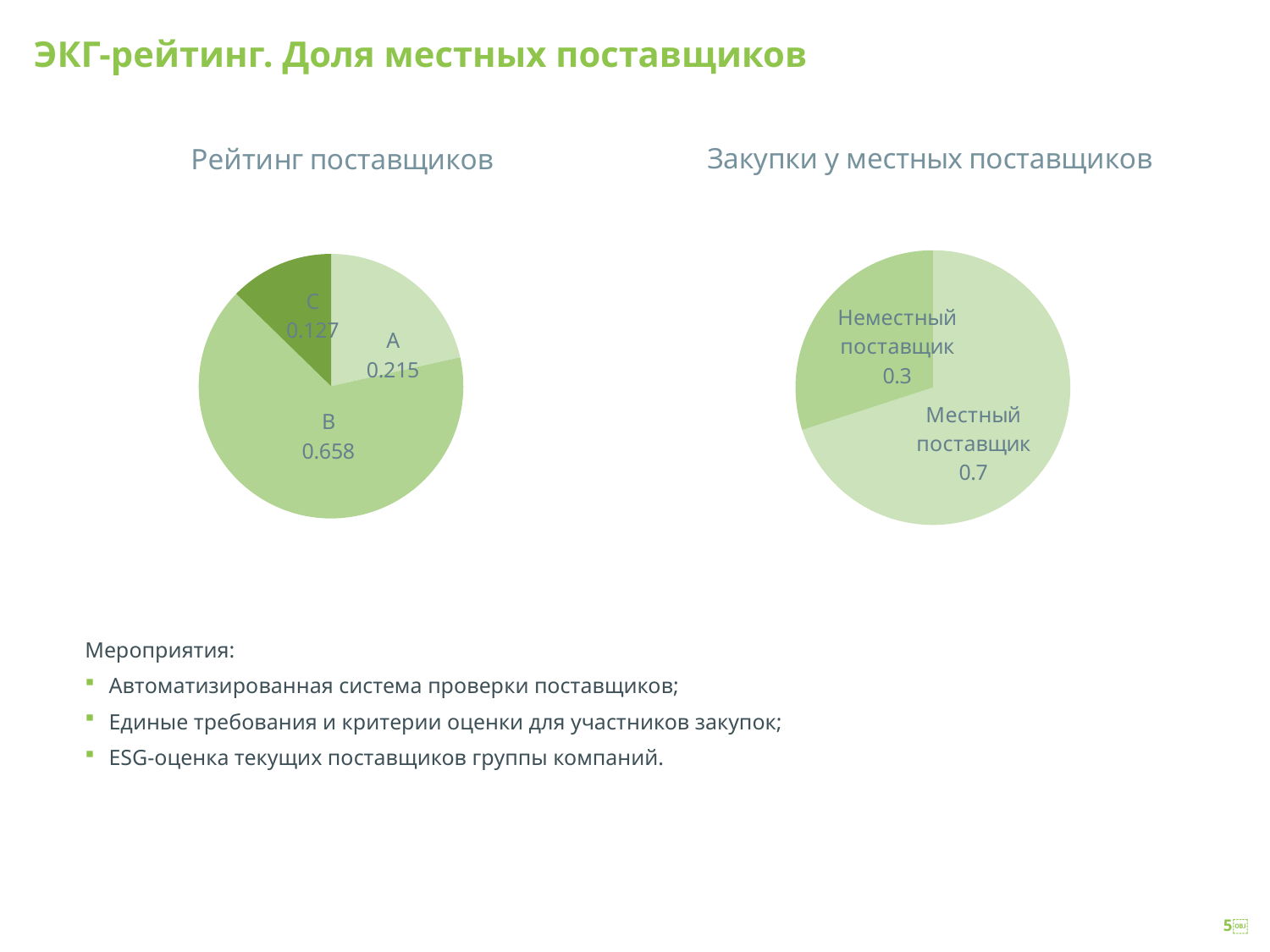
In the 'Рейтинг поставщиков' chart, how many categories are shown? 3 In the 'Рейтинг поставщиков' chart, what is the value for category A? 0.215 In the 'Рейтинг поставщиков' chart, what is the difference between the values for B and A? 0.443 In the 'Рейтинг поставщиков' chart, which category has the smallest slice? C In the 'Рейтинг поставщиков' chart, what is the value for category B? 0.658 What kind of chart is the 'Закупки у местных поставщиков' chart? Pie chart In the 'Закупки у местных поставщиков' chart, which is larger: 'Местный поставщик' or 'Неместный поставщик'? Местный поставщик In the 'Рейтинг поставщиков' chart, which category has the largest slice? B In the 'Закупки у местных поставщиков' chart, what is the value for 'Неместный поставщик'? 0.3 In the 'Закупки у местных поставщиков' chart, what is the value for 'Местный поставщик'? 0.7 What is the title of the chart on the left side of the slide? Рейтинг поставщиков In the 'Рейтинг поставщиков' chart, what is the value for category C? 0.127